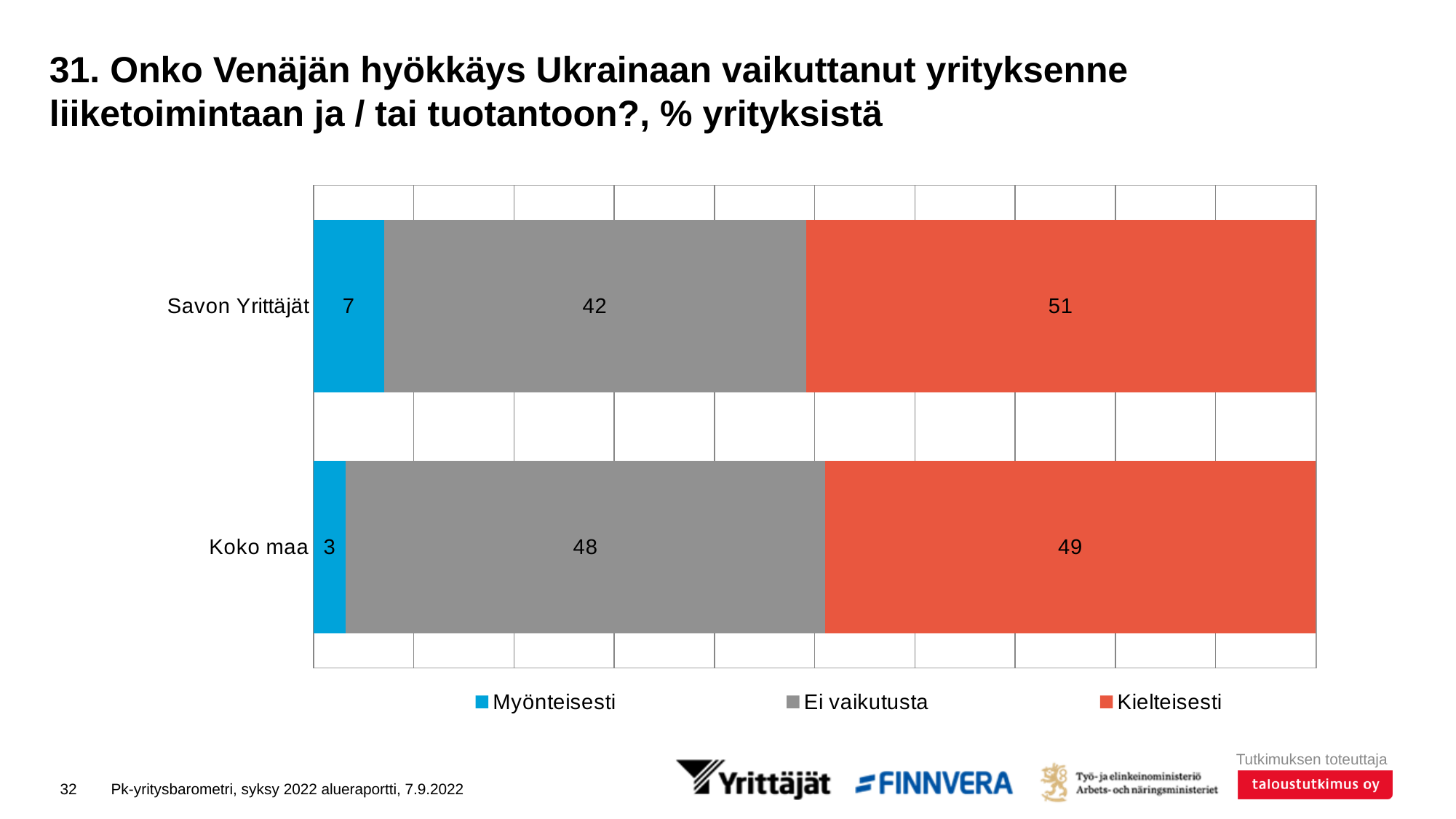
Which category has the higher Ei vaikutusta value, Savon Yrittäjät or Koko maa? Koko maa What kind of chart is shown on the slide? Stacked bar chart Which category has the higher Myönteisesti value, Savon Yrittäjät or Koko maa? Savon Yrittäjät What is the difference between the Myönteisesti values for Savon Yrittäjät and Koko maa? 4 What is the value for Kielteisesti for Savon Yrittäjät? 51 What is the total of the stacked bar for Savon Yrittäjät? 100 What is the value for Myönteisesti for Savon Yrittäjät? 7 What is the difference between the Ei vaikutusta values for Koko maa and Savon Yrittäjät? 6 How many series does the legend list? 3 What is the value for Ei vaikutusta for Koko maa? 48 How many categories are shown on the chart? 2 What is the value for Kielteisesti for Koko maa? 49